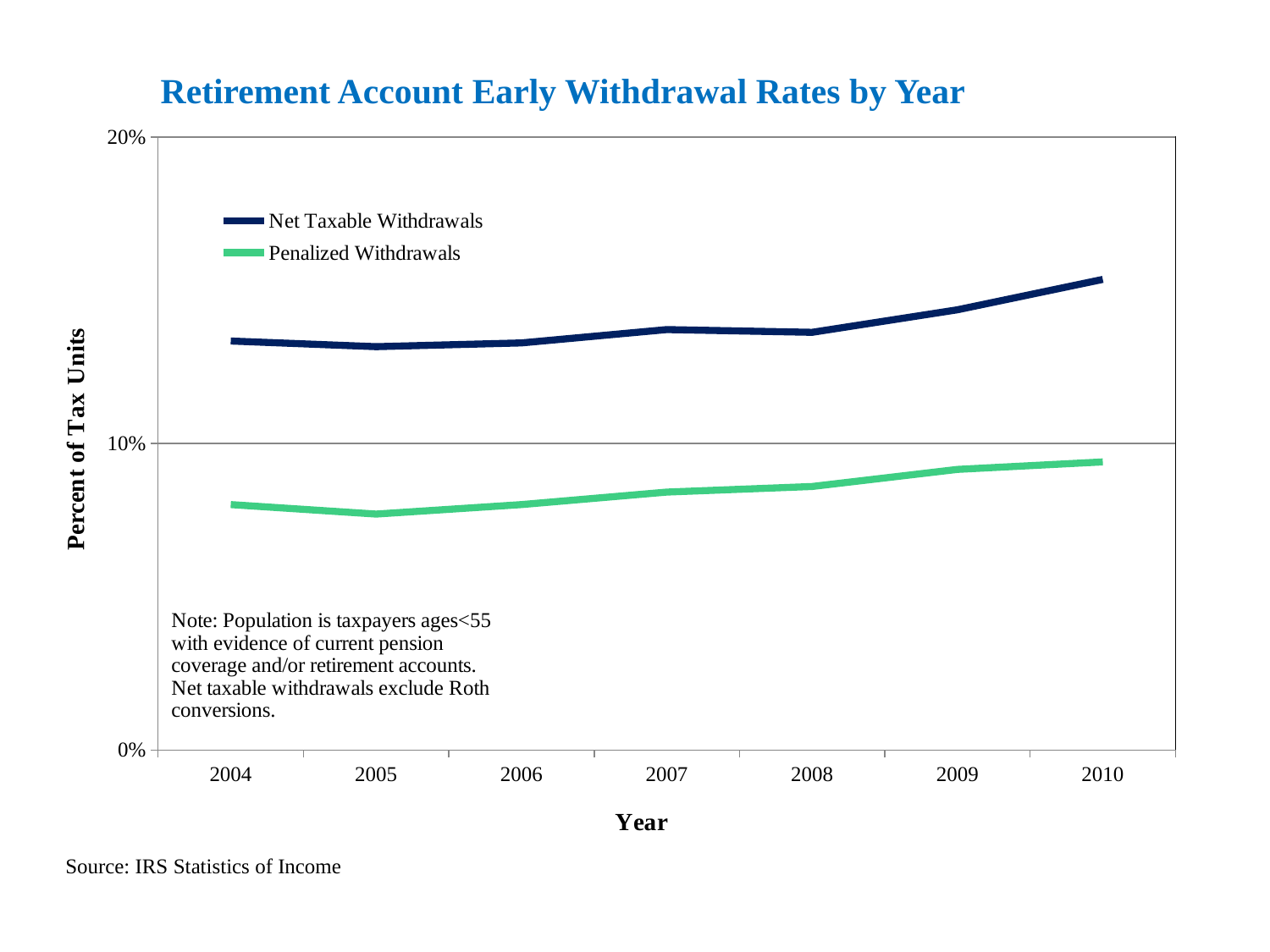
What is the title of the chart? Retirement Account Early Withdrawal Rates by Year How many years are plotted along the x axis? 7 Is the value for Net Taxable Withdrawals in 2010 greater or less than 10%? greater How many series does the legend list? 2 Is the value for Penalized Withdrawals in 2010 greater or less than 10%? less Which year has the highest value for Net Taxable Withdrawals? 2010 What kind of chart is shown on the slide? line chart In 2008, which series has the larger value, Net Taxable Withdrawals or Penalized Withdrawals? Net Taxable Withdrawals Which year has the highest value for Penalized Withdrawals? 2010 Which year has the lowest value for Penalized Withdrawals? 2005 Is the value for Net Taxable Withdrawals in 2004 greater or less than 20%? less Do the values for Penalized Withdrawals generally rise or fall from 2005 to 2010? rise